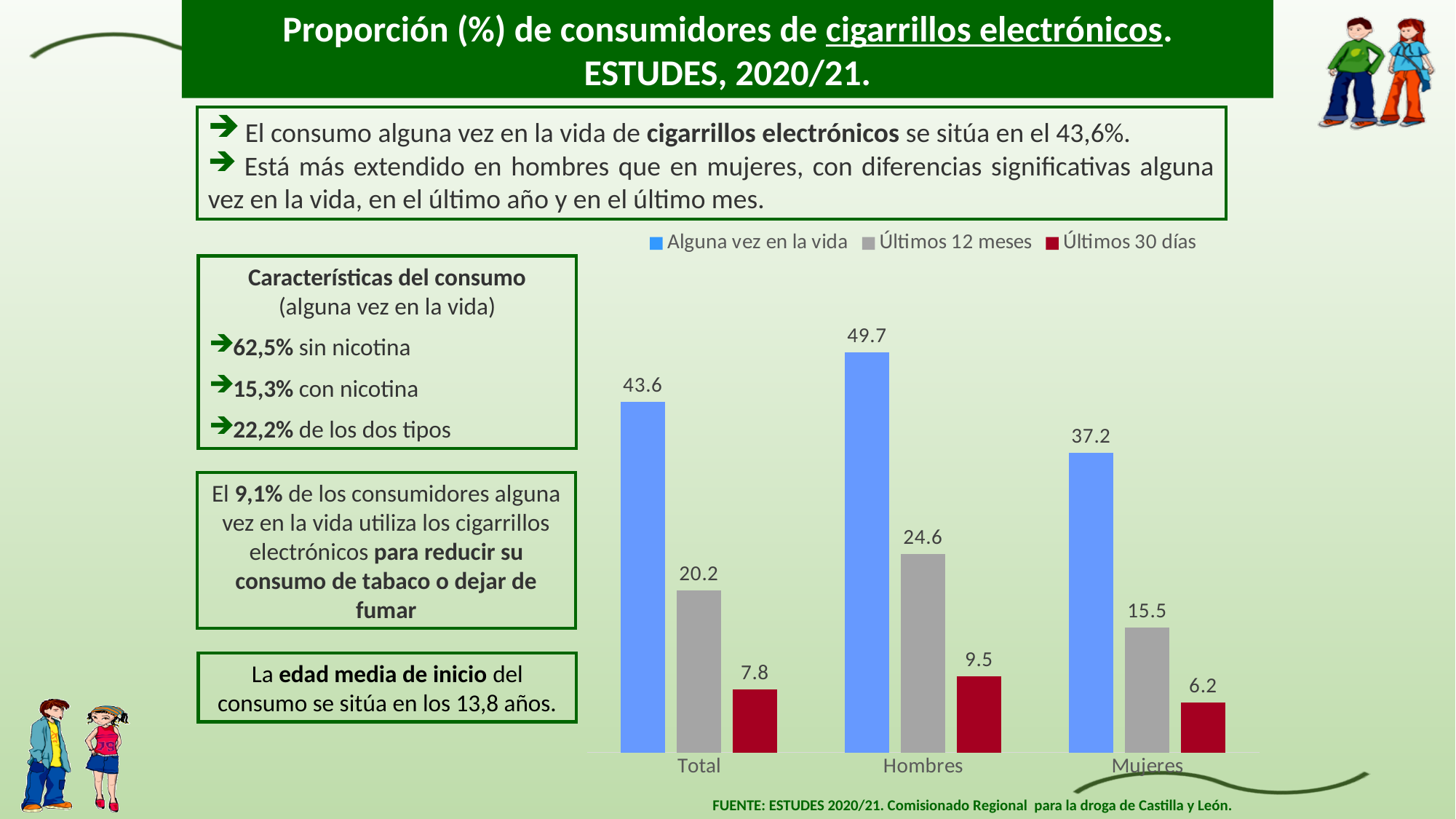
What is the difference between the 'Últimos 12 meses' values for Hombres and Total? 4.4 How many categories are shown on the x axis? 3 What kind of chart is shown on the slide? Bar chart What is the value for 'Últimos 12 meses' for Mujeres? 15.5 Which category has the highest value for 'Alguna vez en la vida'? Hombres What is the value for 'Alguna vez en la vida' in the Total category? 43.6 What is the difference between the 'Alguna vez en la vida' values for Hombres and Mujeres? 12.5 What is the value for 'Últimos 30 días' for Hombres? 9.5 Which category has the lowest value for 'Últimos 30 días'? Mujeres Which is larger: 'Últimos 12 meses' for Total or 'Últimos 12 meses' for Mujeres? Total How many series does the legend list? 3 Which colour represents the 'Últimos 30 días' series? Dark red